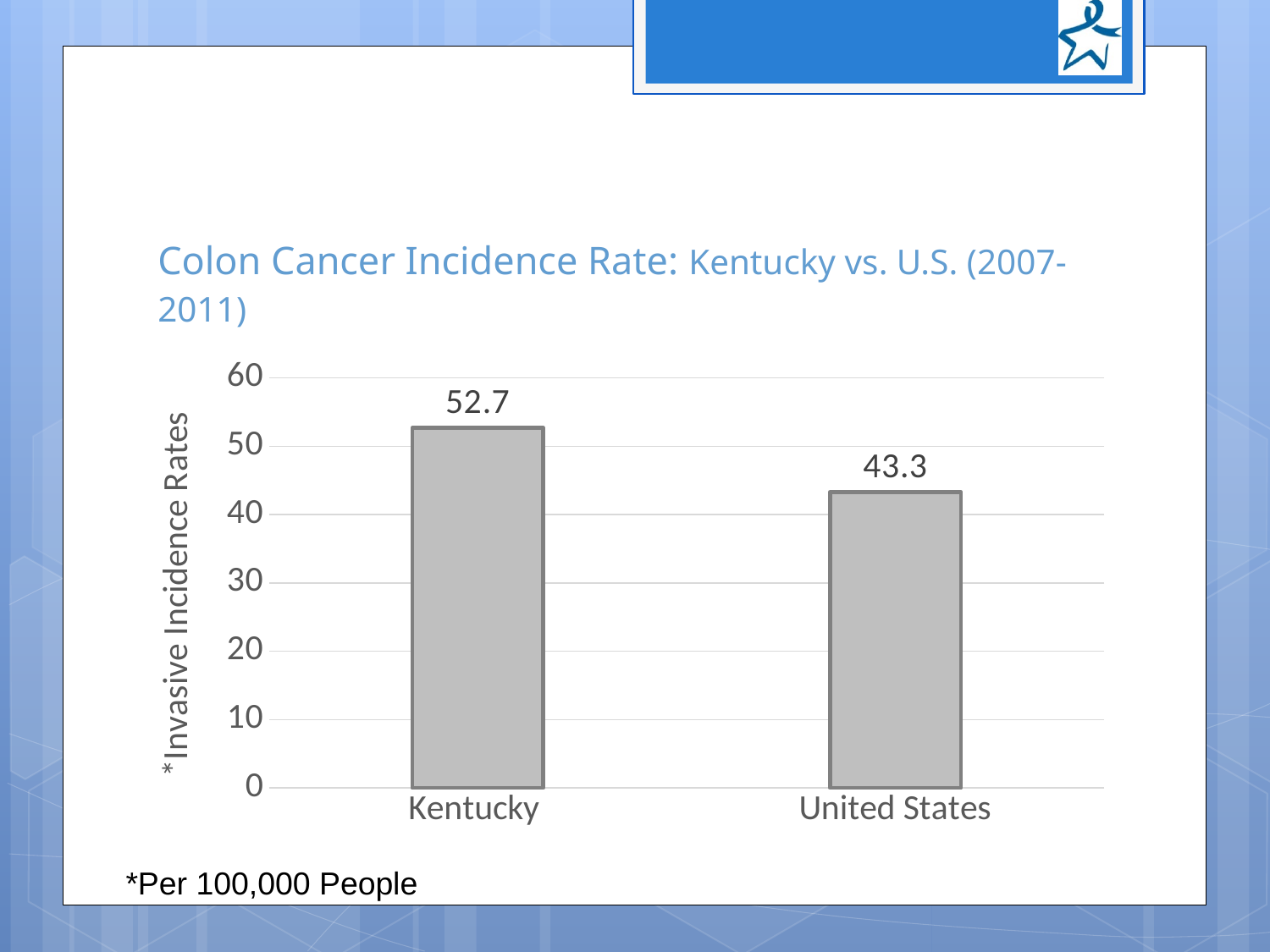
Which category has the higher incidence rate? Kentucky What kind of chart is shown on the slide? bar chart Which category has the lower incidence rate? United States Is the value for the United States greater or less than 50? less How many categories are shown on the x axis? 2 What is the difference between the Kentucky and United States incidence rates? 9.4 What is the invasive incidence rate for the United States? 43.3 What is the title of the chart? Colon Cancer Incidence Rate: Kentucky vs. U.S. (2007-2011) Is the value for Kentucky greater or less than 50? greater What is the invasive incidence rate for Kentucky? 52.7 Is the incidence rate for Kentucky larger or smaller than that for the United States? larger What is the label of the vertical axis? *Invasive Incidence Rates